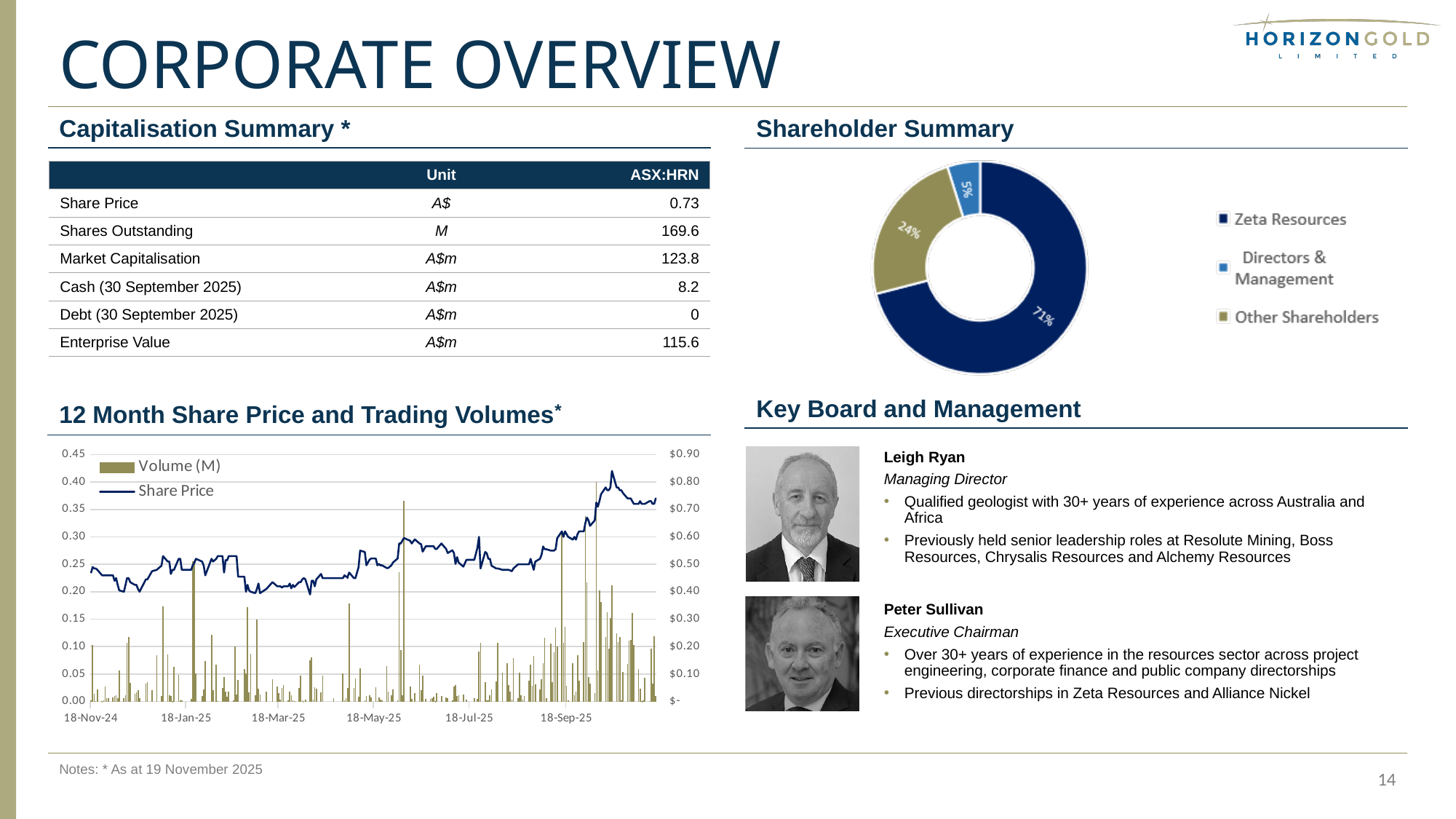
In the Shareholder Summary chart, which shareholder group holds the smallest share? Directors & Management In the 12 Month Share Price and Trading Volumes chart, is the share price at the end of the period greater or less than $0.60? greater In the Shareholder Summary chart, what percentage is held by Directors & Management? 5% In the 12 Month Share Price and Trading Volumes chart, does the share price overall rise or fall from 18-Nov-24 to the end of the period? Rise In the Shareholder Summary chart, what share is held by Other Shareholders? 24% In the Shareholder Summary chart, how many percentage points larger is the Zeta Resources share than the Other Shareholders share? 47 In the Shareholder Summary chart, which shareholder group holds the largest share? Zeta Resources In the 12 Month Share Price and Trading Volumes chart, which series is plotted as bars? Volume (M) What type of chart is the Shareholder Summary chart? Pie (donut) chart In the 12 Month Share Price and Trading Volumes chart, how many series does the legend list? 2 In the Shareholder Summary chart, what percentage of shares is held by Zeta Resources? 71% In the Shareholder Summary chart, how many shareholder groups are shown? 3